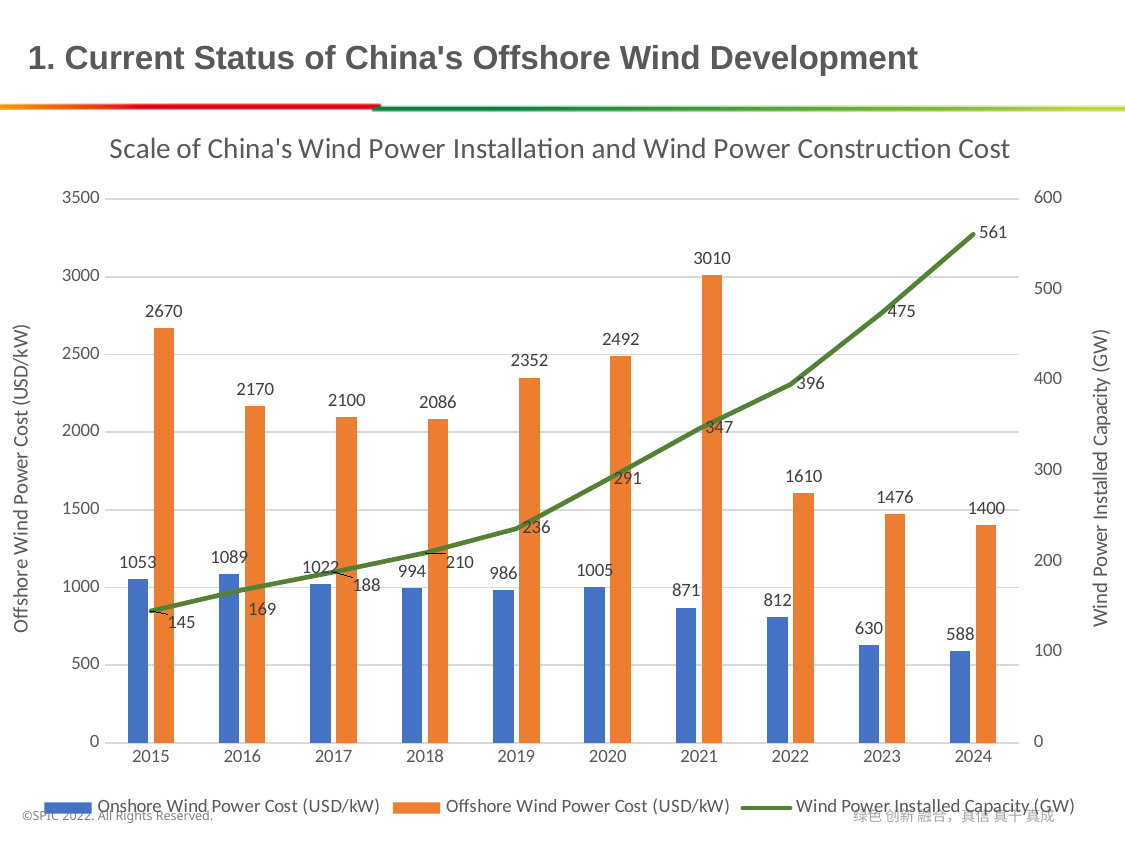
How many years are shown on the x axis? 10 In which year is the Offshore Wind Power Cost highest? 2021 Does the Wind Power Installed Capacity rise or fall from 2015 to 2024? Rise What is the Onshore Wind Power Cost (USD/kW) in 2024? 588 By how much did the Offshore Wind Power Cost fall from 2021 to 2022? 1400 In which year is the Onshore Wind Power Cost lowest? 2024 What is the Offshore Wind Power Cost (USD/kW) in 2021? 3010 What is the Wind Power Installed Capacity (GW) in 2020? 291 Which year has the higher Onshore Wind Power Cost, 2015 or 2016? 2016 What kind of chart is shown on the slide? Bar and line chart How much did the Wind Power Installed Capacity increase from 2015 to 2024? 416 How many series does the legend list? 3